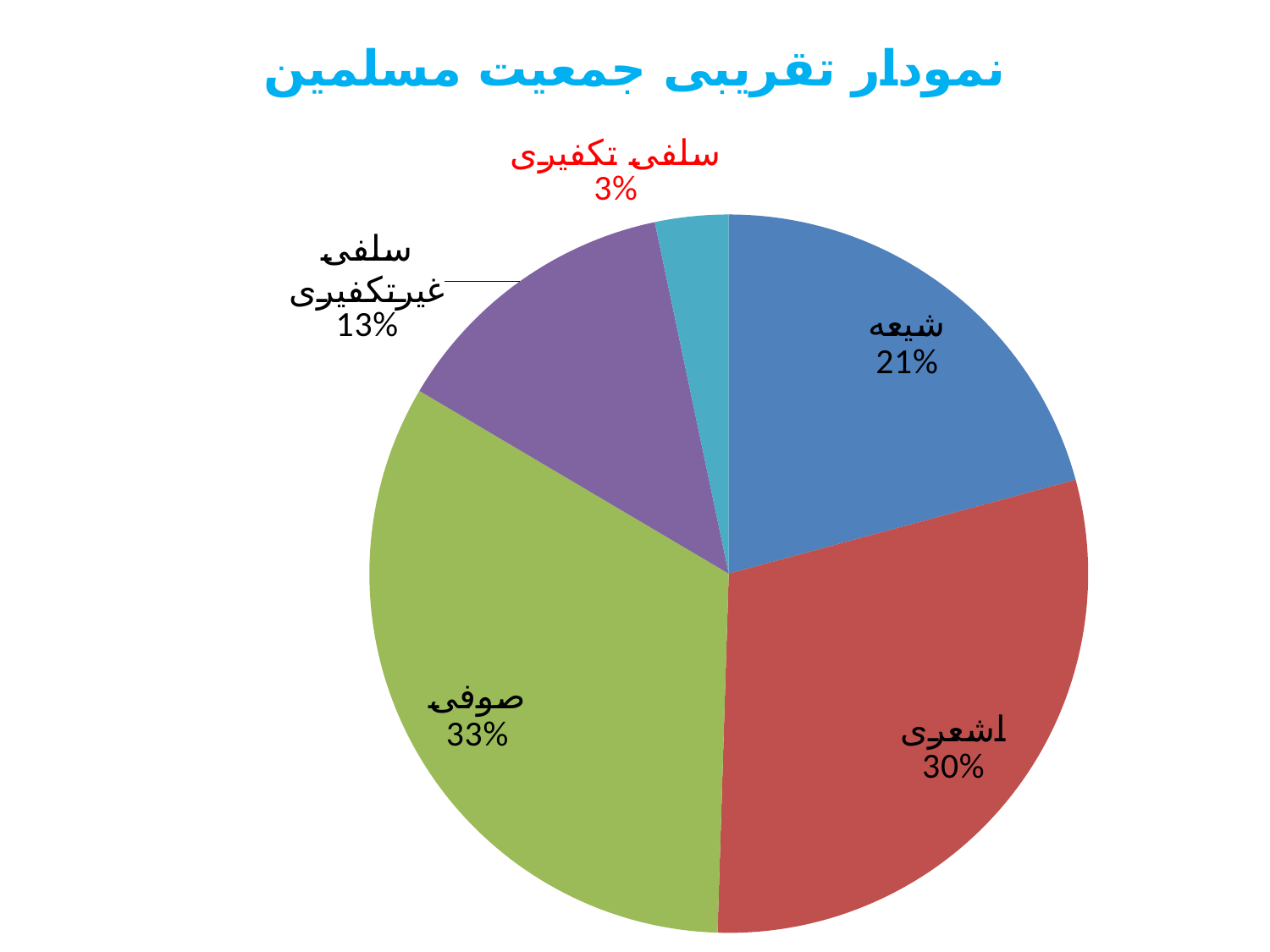
What share of the pie does the شیعه slice represent? 21% Which slice has the smallest share of the pie? سلفی تکفیری What is the difference in percentage points between the صوفی and شیعه slices? 12 What value is labelled on the صوفی slice? 33% How many slices does the pie chart have? 5 What percentage is shown for سلفی غیرتکفیری? 13% What is the title of the chart? نمودار تقریبی جمعیت مسلمین Which slice has the largest share of the pie? صوفی What kind of chart is shown on the slide? Pie chart Which is larger, the اشعری slice or the شیعه slice? اشعری What percentage is shown for the اشعری slice? 30% What percentage is shown for سلفی تکفیری? 3%